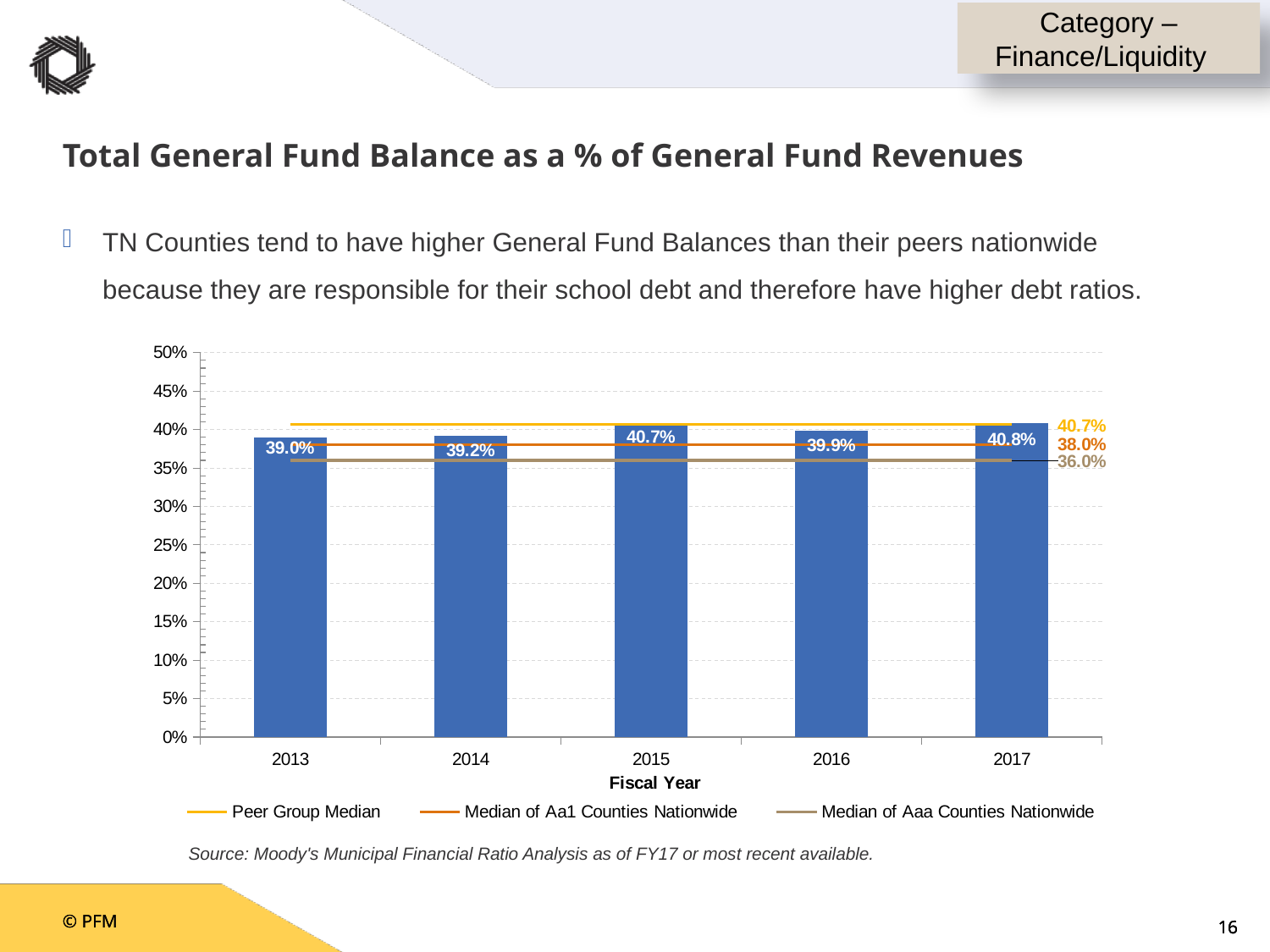
What is the Total General Fund Balance as a % of General Fund Revenues for fiscal year 2015? 40.7% What is the Median of Aaa Counties Nationwide shown on the chart? 36.0% What kind of chart is used to show the fiscal year values? Bar chart Is the value for 2016 greater or less than 35%? greater What is the difference between the 2017 value and the 2013 value? 1.8 percentage points What value is shown for fiscal year 2013? 39.0% Which is larger, the value for 2016 or the value for 2014? 2016 What is the difference between the Median of Aa1 Counties Nationwide and the Median of Aaa Counties Nationwide? 2.0 percentage points How many series does the legend list? 3 How many fiscal years are shown on the x axis? 5 What is the Peer Group Median value shown on the chart? 40.7% Which fiscal year has the highest bar value? 2017